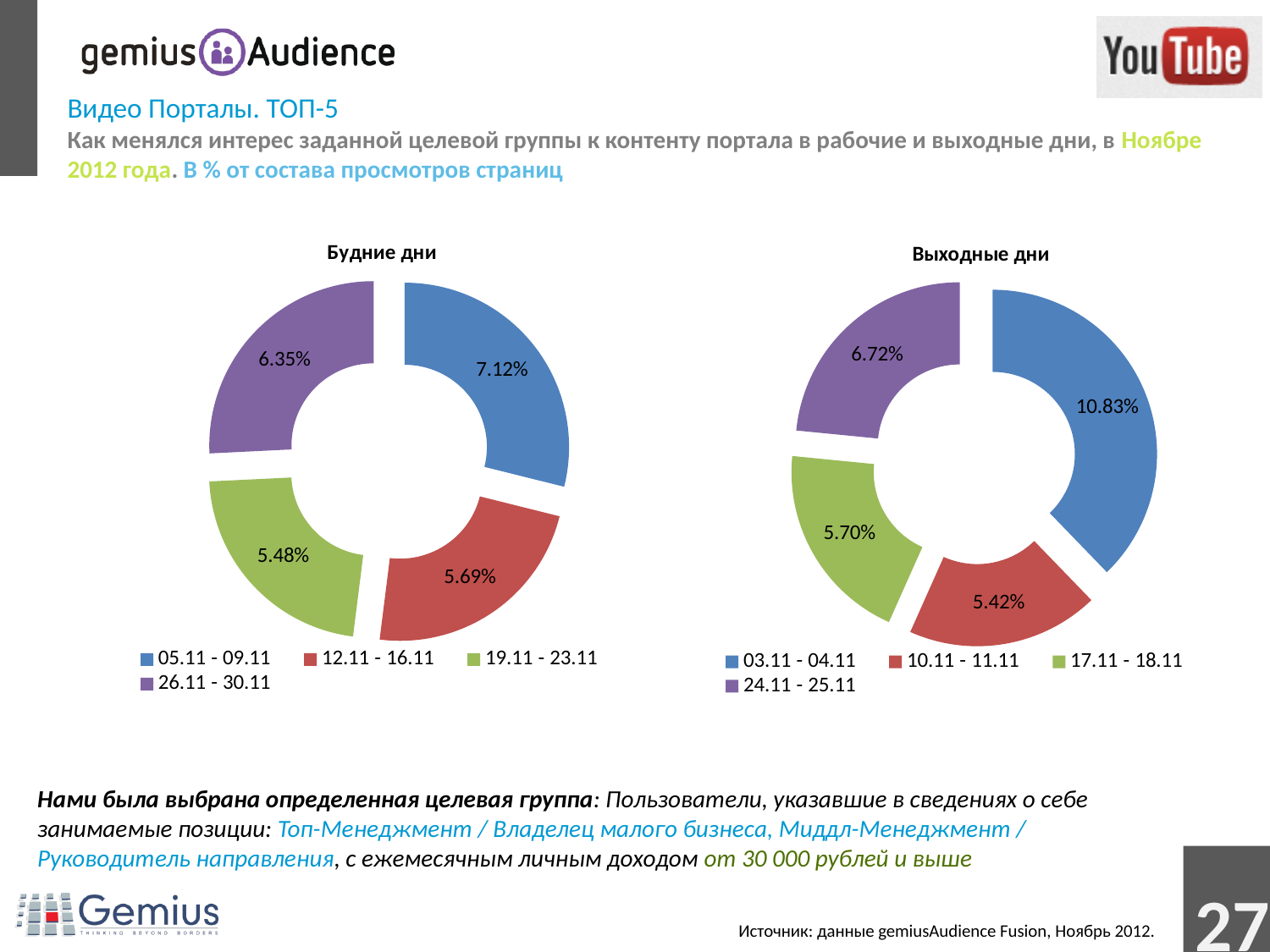
In the 'Будние дни' chart, what is the value for 05.11 - 09.11? 7.12% In the 'Будние дни' chart, what is the value for 19.11 - 23.11? 5.48% In the 'Будние дни' chart, which period has the lowest value? 19.11 - 23.11 Which is larger: the value for 05.11 - 09.11 in the 'Будние дни' chart or the value for 03.11 - 04.11 in the 'Выходные дни' chart? 03.11 - 04.11 in 'Выходные дни' In the 'Выходные дни' chart, what is the difference between the values for 03.11 - 04.11 and 24.11 - 25.11? 4.11% In the 'Выходные дни' chart, which period has the lowest value? 10.11 - 11.11 In the 'Выходные дни' chart, what is the value for 03.11 - 04.11? 10.83% In the 'Будние дни' chart, what is the difference between the values for 26.11 - 30.11 and 12.11 - 16.11? 0.66% In the 'Будние дни' chart, which period has the highest value? 05.11 - 09.11 How many periods does the legend of the 'Выходные дни' chart list? 4 What type of chart is the 'Будние дни' chart? Doughnut chart In the 'Выходные дни' chart, what is the value for 24.11 - 25.11? 6.72%